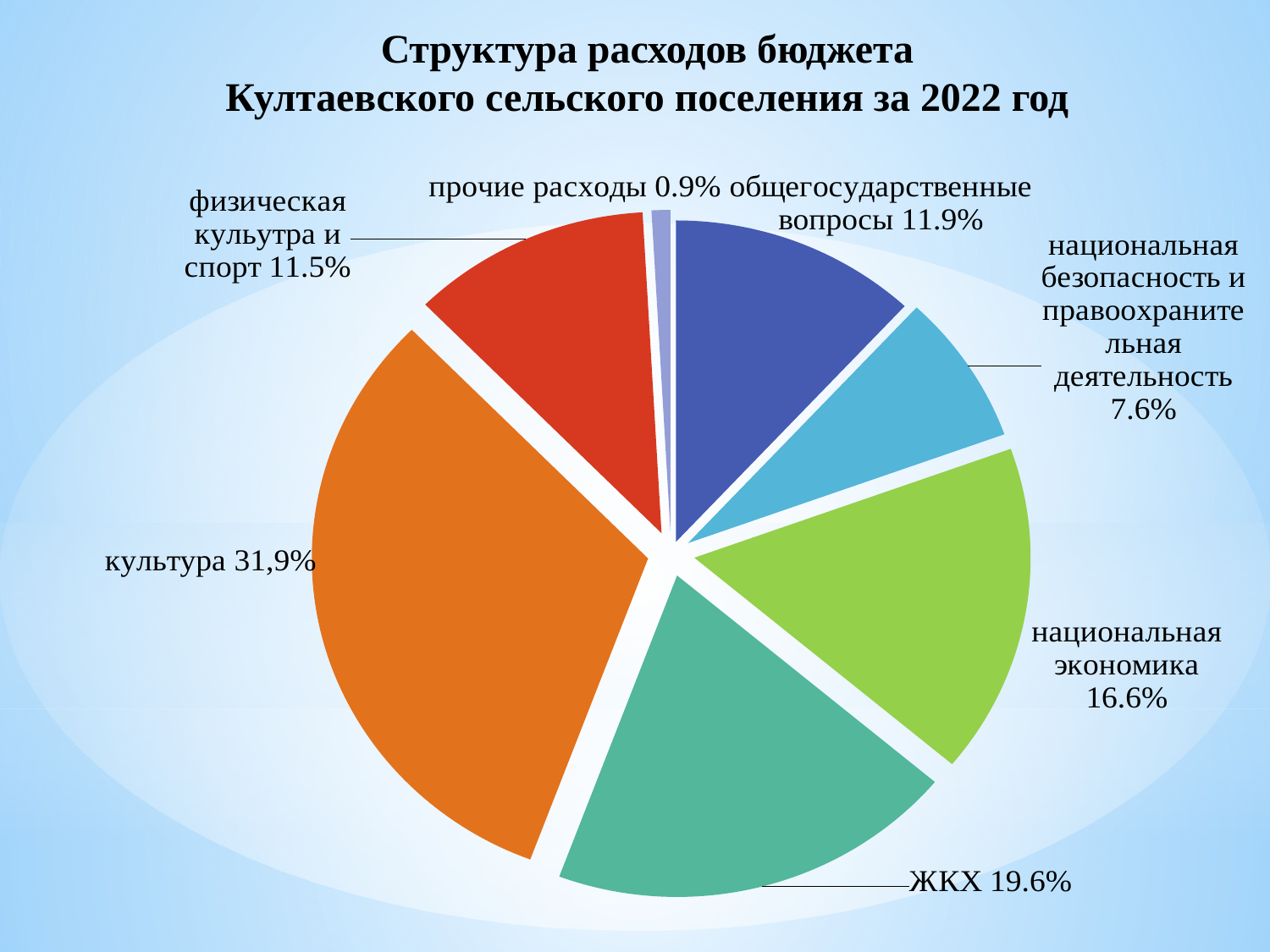
Which category has the smallest share of the budget expenses? прочие расходы What is the difference between the share for ЖКХ and the share for национальная экономика? 3.0% What share of the budget expenses is прочие расходы? 0.9% What is the title of the chart? Структура расходов бюджета Култаевского сельского поселения за 2022 год What type of chart is shown on the slide? pie chart What share of the budget expenses is ЖКХ? 19.6% What share of the budget expenses is культура? 31,9% Which is larger: the share for ЖКХ or the share for национальная экономика? ЖКХ What share of the budget expenses is национальная экономика? 16.6% What share of the budget expenses is национальная безопасность и правоохранительная деятельность? 7.6% How many slices does the pie chart have? 7 Which category has the largest share of the budget expenses? культура